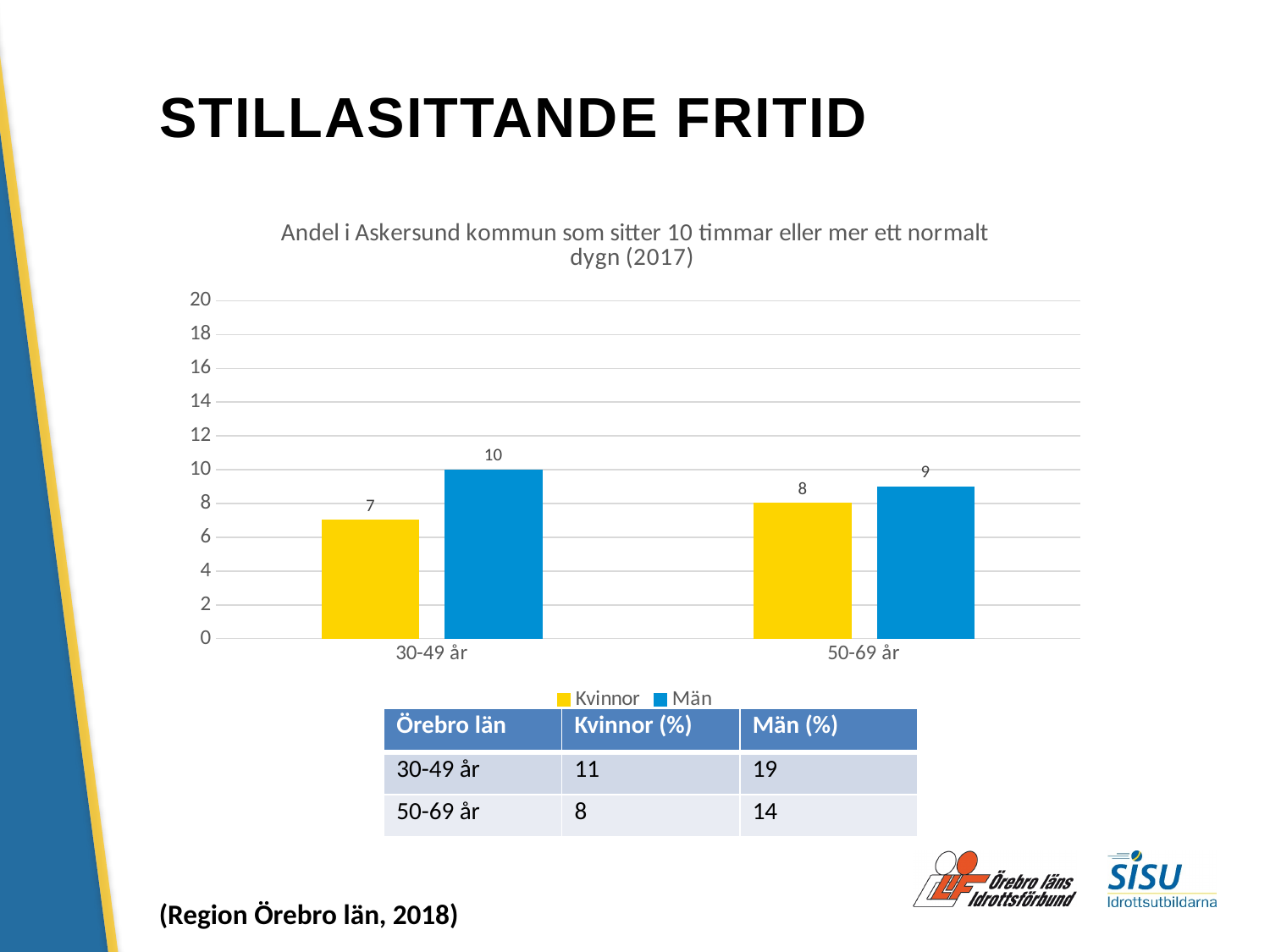
What is the value for Män in the 50-69 år category? 9 What is the value for Kvinnor in the 30-49 år category? 7 What is the value for Kvinnor in the 50-69 år category? 8 What colour are the Kvinnor bars? Yellow What is the value for Män in the 30-49 år category? 10 Which bar has the highest value in the chart? Män, 30-49 år How many age categories are shown on the x axis? 2 What kind of chart is shown on the slide? Bar chart How many series does the legend list? 2 Which bar has the lowest value in the chart? Kvinnor, 30-49 år Which is larger in the 50-69 år category, Kvinnor or Män? Män What is the difference between Män and Kvinnor in the 30-49 år category? 3